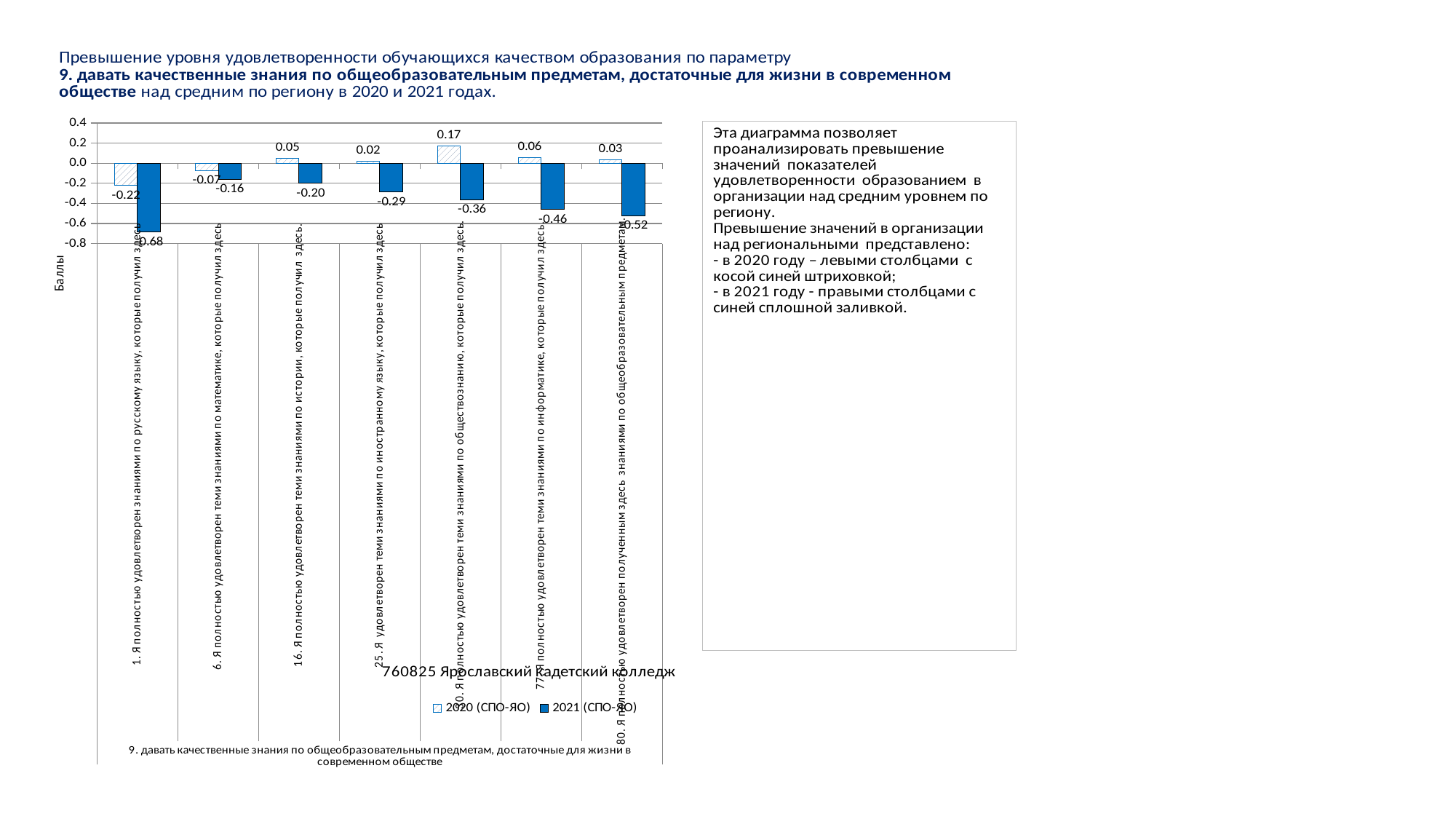
What is the difference between the 2020 and 2021 values for the category about knowledge of history (истории)? 0.25 What kind of chart is shown on the slide? bar chart What is the 2020 (СПО-ЯО) value for the category about knowledge of mathematics (математике)? -0.07 What is the 2021 (СПО-ЯО) value for the category about knowledge of Russian language (русскому языку)? -0.68 Which category has the highest 2020 (СПО-ЯО) value? обществознанию (social studies) What is the 2020 (СПО-ЯО) value for the category about knowledge of social studies (обществознанию)? 0.17 How many series does the chart legend list? 2 What is the label of the y axis? Баллы Which category has the lowest 2021 (СПО-ЯО) value? русскому языку (Russian language) What is the 2021 (СПО-ЯО) value for the category about knowledge of informatics (информатике)? -0.46 How many categories are plotted on the chart? 7 Which is larger for the category about foreign language (иностранному языку): the 2020 (СПО-ЯО) value or the 2021 (СПО-ЯО) value? 2020 (СПО-ЯО)